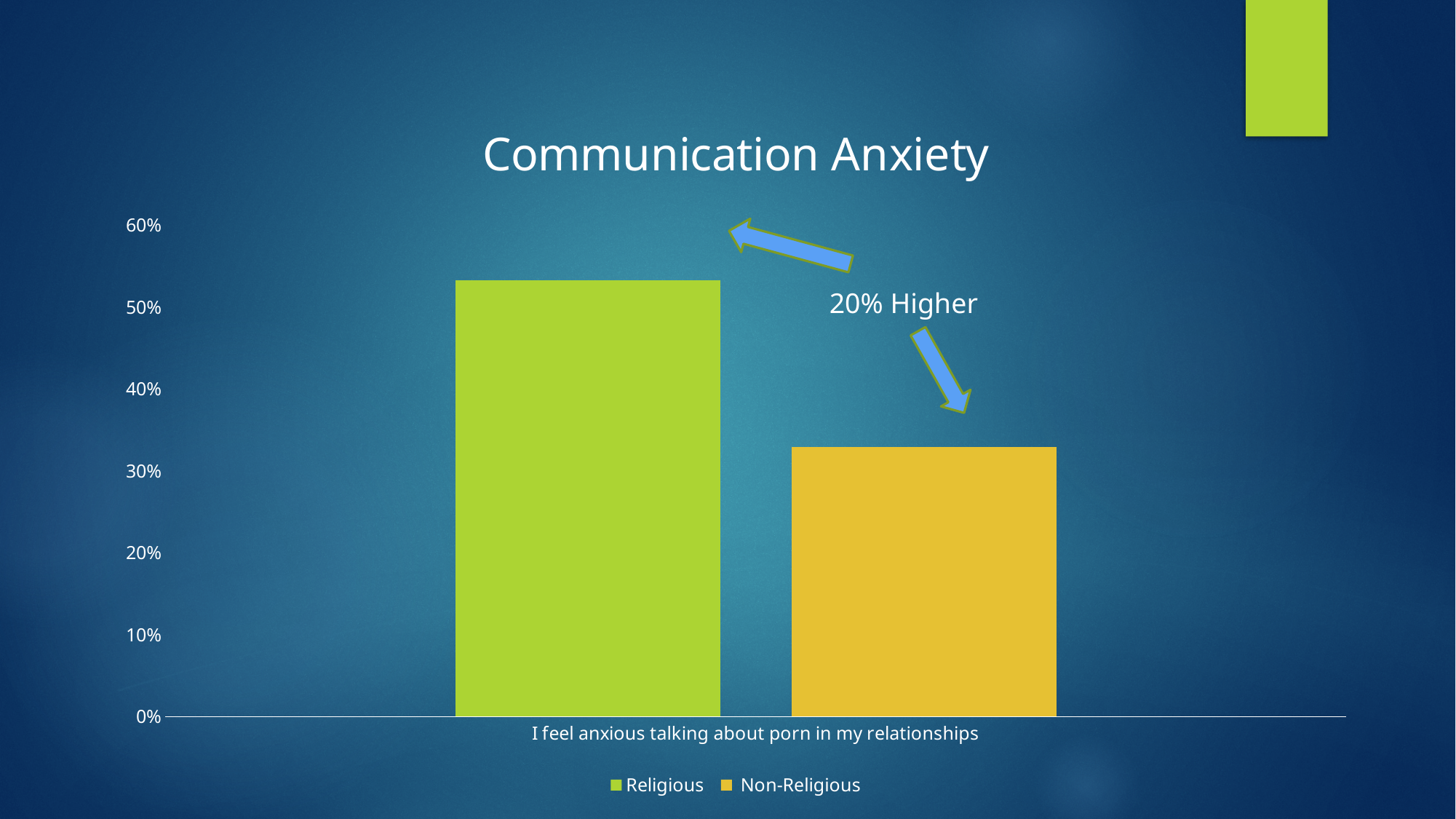
Is the Religious bar larger or smaller than the Non-Religious bar? larger What does the annotation between the two arrows on the chart say? 20% Higher Is the value for Non-Religious greater or less than 40%? less How many series does the legend list? 2 What is the title of the chart? Communication Anxiety Is the value for Religious greater or less than 50%? greater Which series has the higher bar for "I feel anxious talking about porn in my relationships"? Religious Is the value for Non-Religious greater or less than 30%? greater How many categories are shown on the x axis? 1 Which series has the lower bar for "I feel anxious talking about porn in my relationships"? Non-Religious What kind of chart is shown on the slide? bar chart